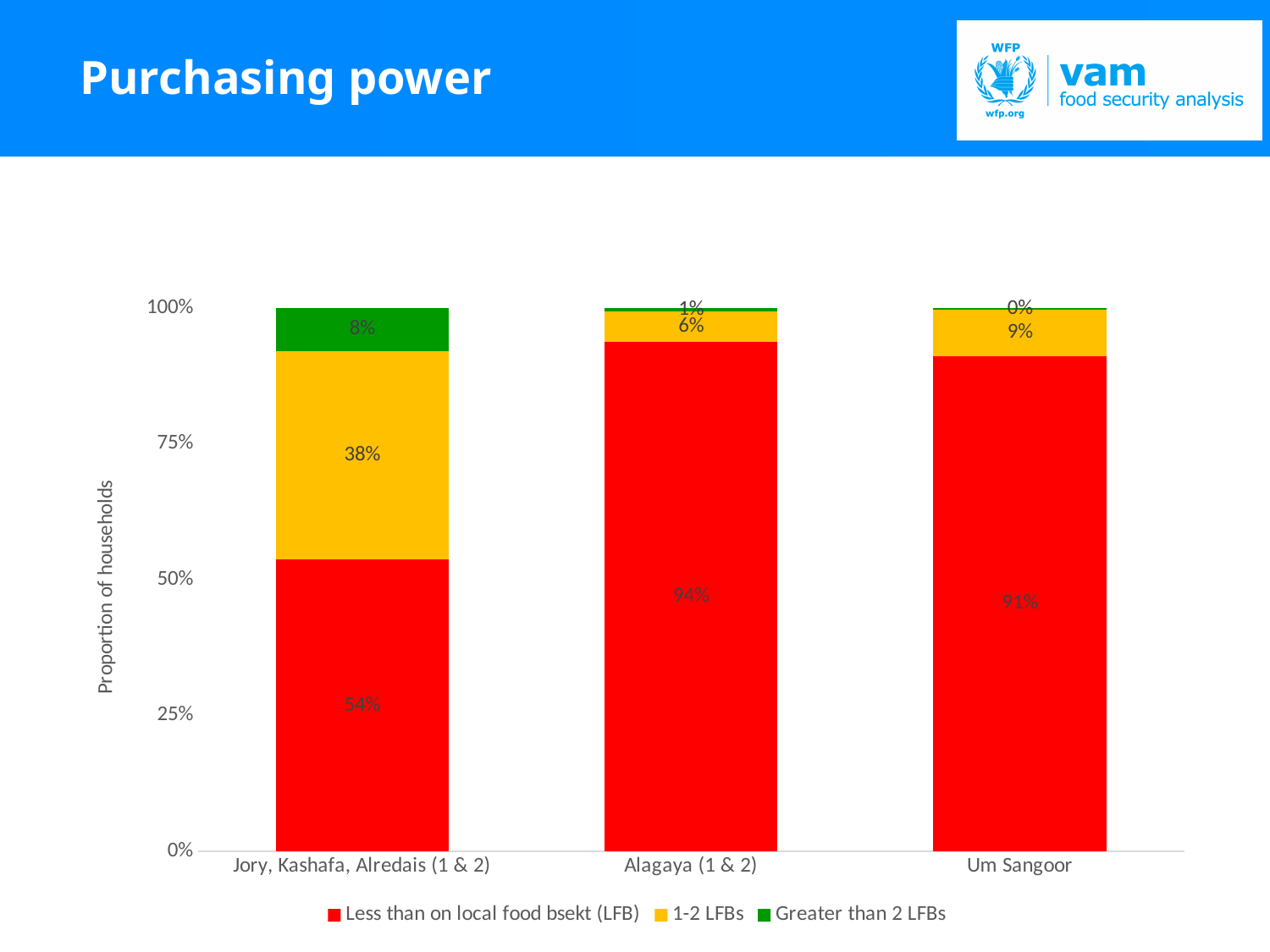
Which location has the highest share of households with less than one local food basket (LFB)? Alagaya (1 & 2) How many locations are shown on the x axis? 3 What is the value for 1-2 LFBs in Um Sangoor? 9% What is the value for Greater than 2 LFBs in Um Sangoor? 0% What is the difference between the Less than one LFB values for Alagaya (1 & 2) and Jory, Kashafa, Alredais (1 & 2)? 40% What percentage of households in Alagaya (1 & 2) have less than one local food basket (LFB)? 94% How many series does the legend list? 3 Which is larger: the 1-2 LFBs value for Um Sangoor or for Alagaya (1 & 2)? Um Sangoor What kind of chart is shown on the slide? Stacked bar chart Which location has the lowest share of households with less than one local food basket (LFB)? Jory, Kashafa, Alredais (1 & 2) What is the label of the y axis? Proportion of households What is the value for 1-2 LFBs in Jory, Kashafa, Alredais (1 & 2)? 38%